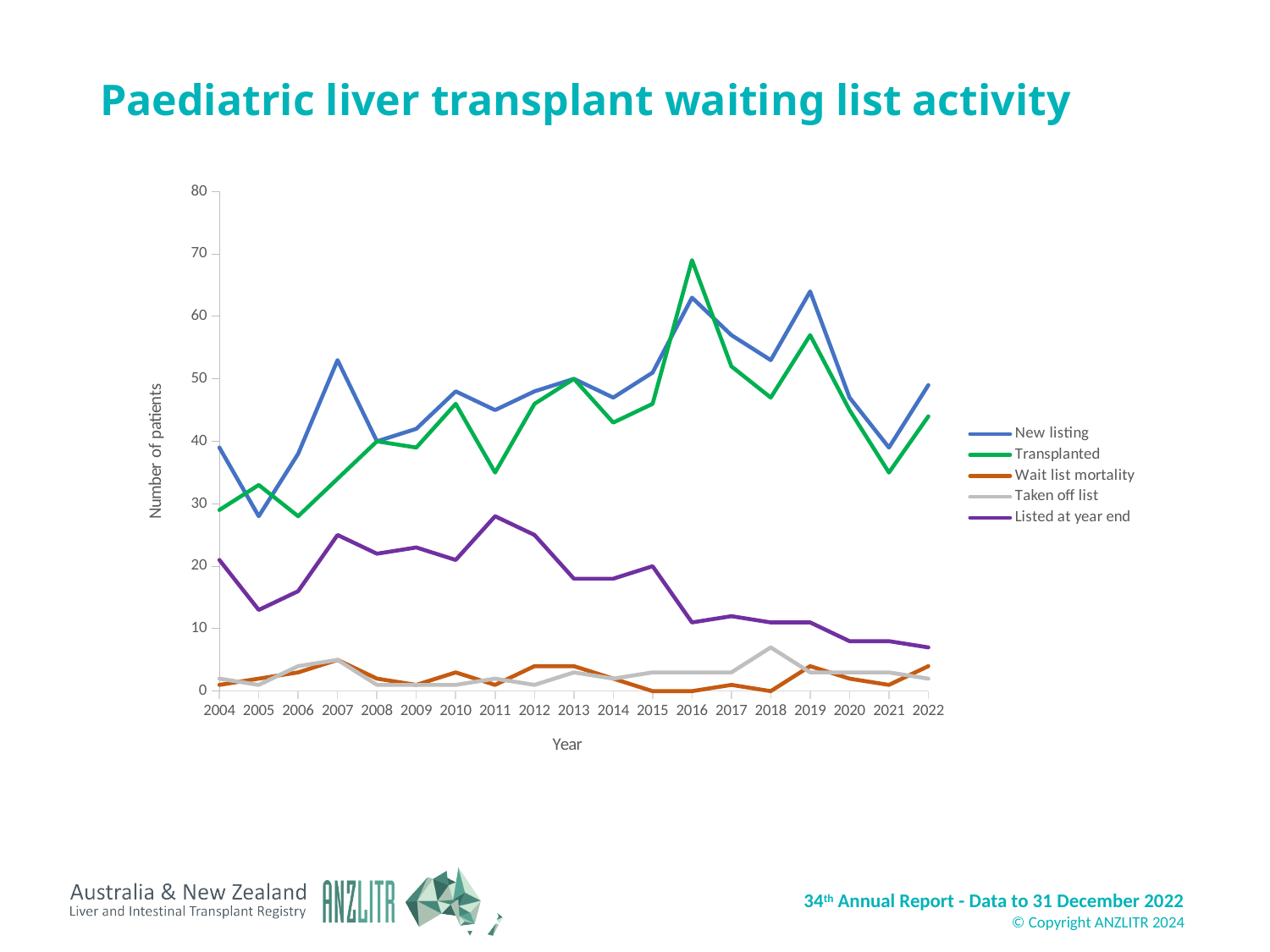
In which year is the New listing series at its lowest? 2005 In 2016, which is higher: New listing or Transplanted? Transplanted In which year is the Listed at year end series at its lowest? 2022 Is the value for Transplanted in 2011 greater or less than 40? less How many series does the legend list? 5 What kind of chart is shown on the slide? Line chart How many years are shown along the x axis? 19 Is the value for New listing in 2007 greater or less than 50? greater Is the value for Listed at year end in 2022 greater or less than 10? less What is the label on the y axis? Number of patients Does the Listed at year end series generally rise or fall from 2011 to 2022? Fall In which year is the Transplanted series at its highest? 2016